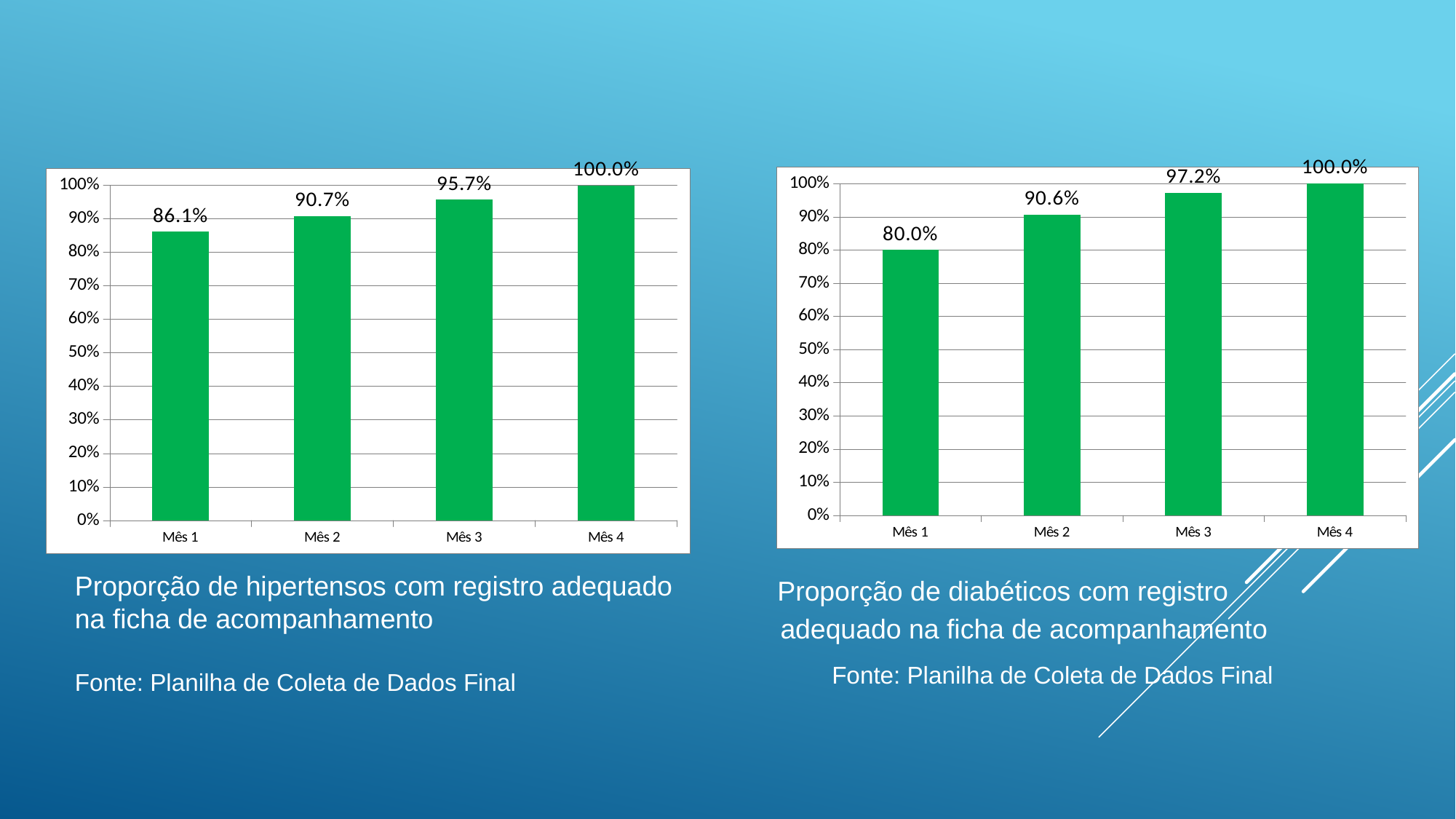
In the right chart (diabéticos), what is the value for Mês 1? 80.0% In the left chart (hipertensos), do the values rise or fall from Mês 1 to Mês 4? Rise In the right chart (diabéticos), which is larger, the value for Mês 2 or Mês 3? Mês 3 In the right chart (diabéticos), what is the difference between the values for Mês 2 and Mês 1? 10.6% In the right chart (diabéticos), what is the value for Mês 3? 97.2% In the left chart (hipertensos), what is the difference between the values for Mês 4 and Mês 1? 13.9% In the left chart (hipertensos), what is the value for Mês 3? 95.7% In the left chart (hipertensos), which month has the lowest value? Mês 1 In the left chart (hipertensos), what is the value for Mês 1? 86.1% In the right chart (diabéticos), which month has the highest value? Mês 4 What kind of chart is the right chart (diabéticos)? Bar chart How many bars are in the left chart (hipertensos)? 4